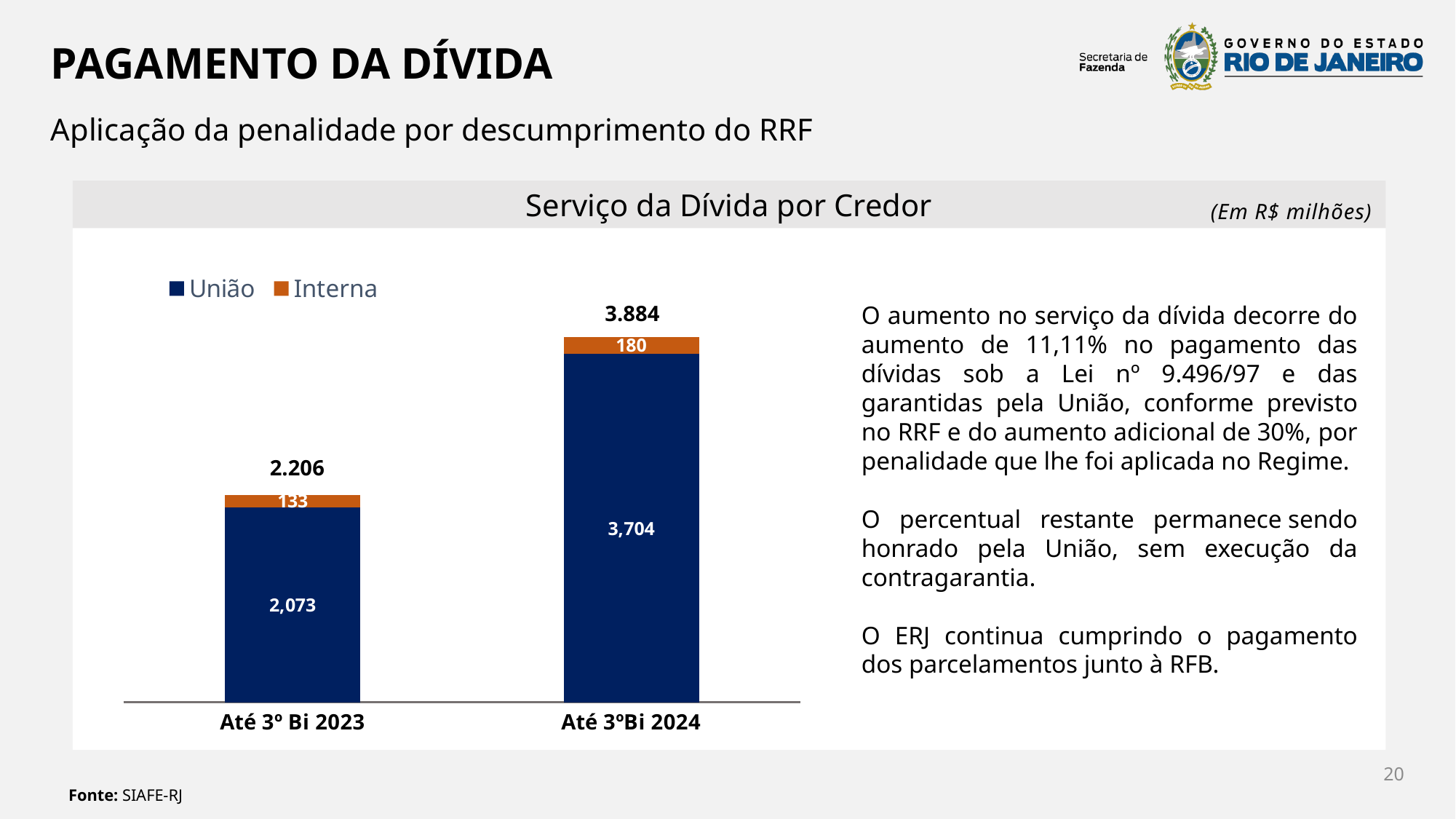
How many series does the legend list? 2 What kind of chart is shown on the slide? Stacked bar chart Which category has the higher total, Até 3º Bi 2023 or Até 3ºBi 2024? Até 3ºBi 2024 What is the total of the stacked bar for Até 3º Bi 2023? 2.206 What is the total of the stacked bar for Até 3ºBi 2024? 3.884 What is the difference between the União values for Até 3ºBi 2024 and Até 3º Bi 2023? 1,631 What is the value for União in the Até 3º Bi 2023 bar? 2,073 How many categories are shown on the x axis? 2 What is the difference between the Interna values for Até 3ºBi 2024 and Até 3º Bi 2023? 47 What is the value for Interna in the Até 3º Bi 2023 bar? 133 What is the value for Interna in the Até 3ºBi 2024 bar? 180 What is the value for União in the Até 3ºBi 2024 bar? 3,704